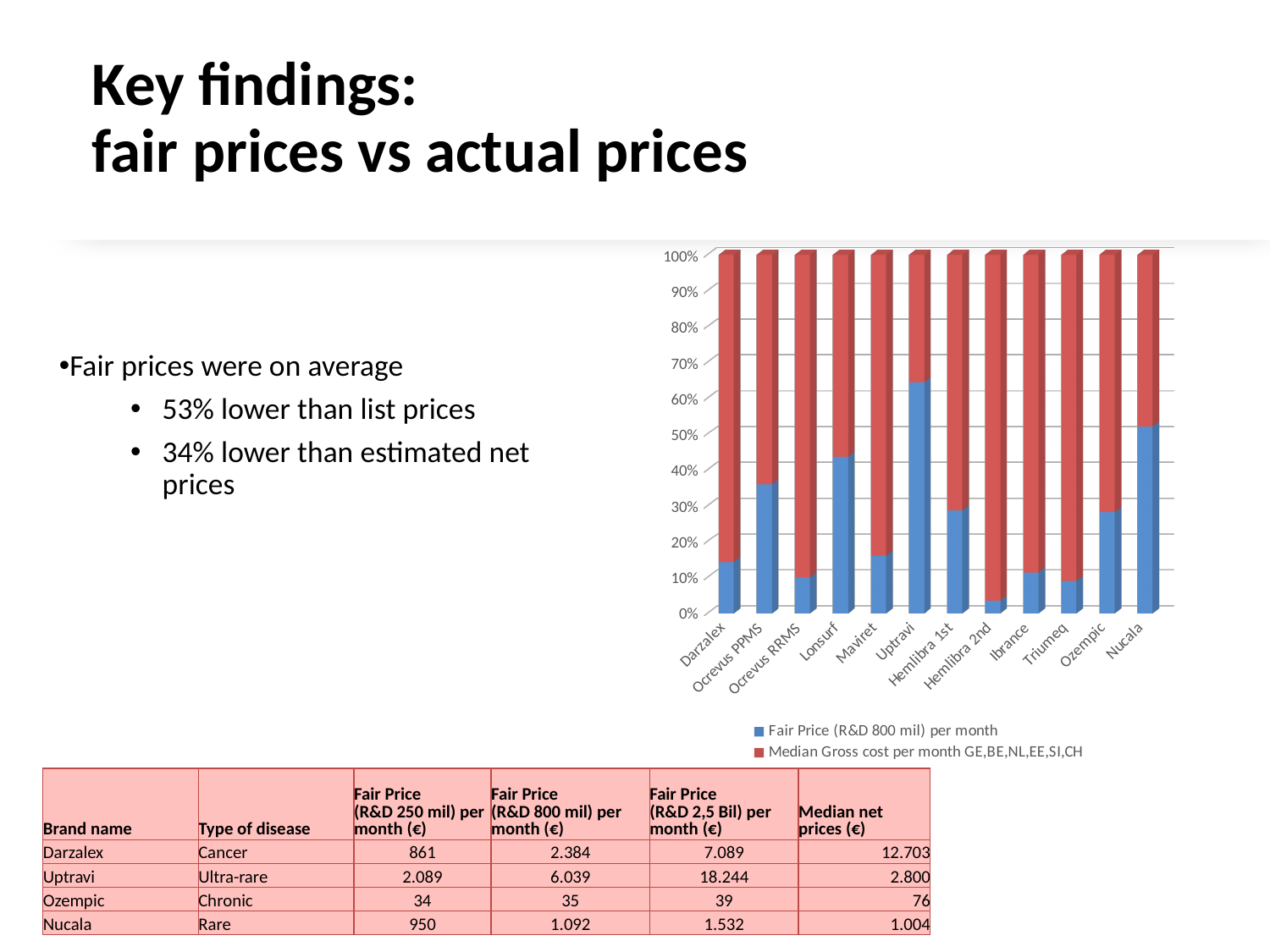
Which series is shown in red in the chart? Median Gross cost per month GE,BE,NL,EE,SI,CH Which brand has the largest Fair Price (R&D 800 mil) share of its bar? Uptravi Which brand has the smallest Fair Price (R&D 800 mil) share of its bar? Hemlibra 2nd How many drug brands (categories) are shown on the x axis of the chart? 12 Which has a larger Fair Price (R&D 800 mil) share of its bar, Lonsurf or Maviret? Lonsurf Is the Fair Price (R&D 800 mil) share for Darzalex greater or less than 20%? less Is the Fair Price (R&D 800 mil) share for Uptravi greater or less than 60%? greater What kind of chart is shown on the slide? stacked bar chart How many series does the chart legend list? 2 What is the total height of each stacked bar in the chart? 100% Which has a larger Median Gross cost share of its bar, Hemlibra 2nd or Ocrevus PPMS? Hemlibra 2nd